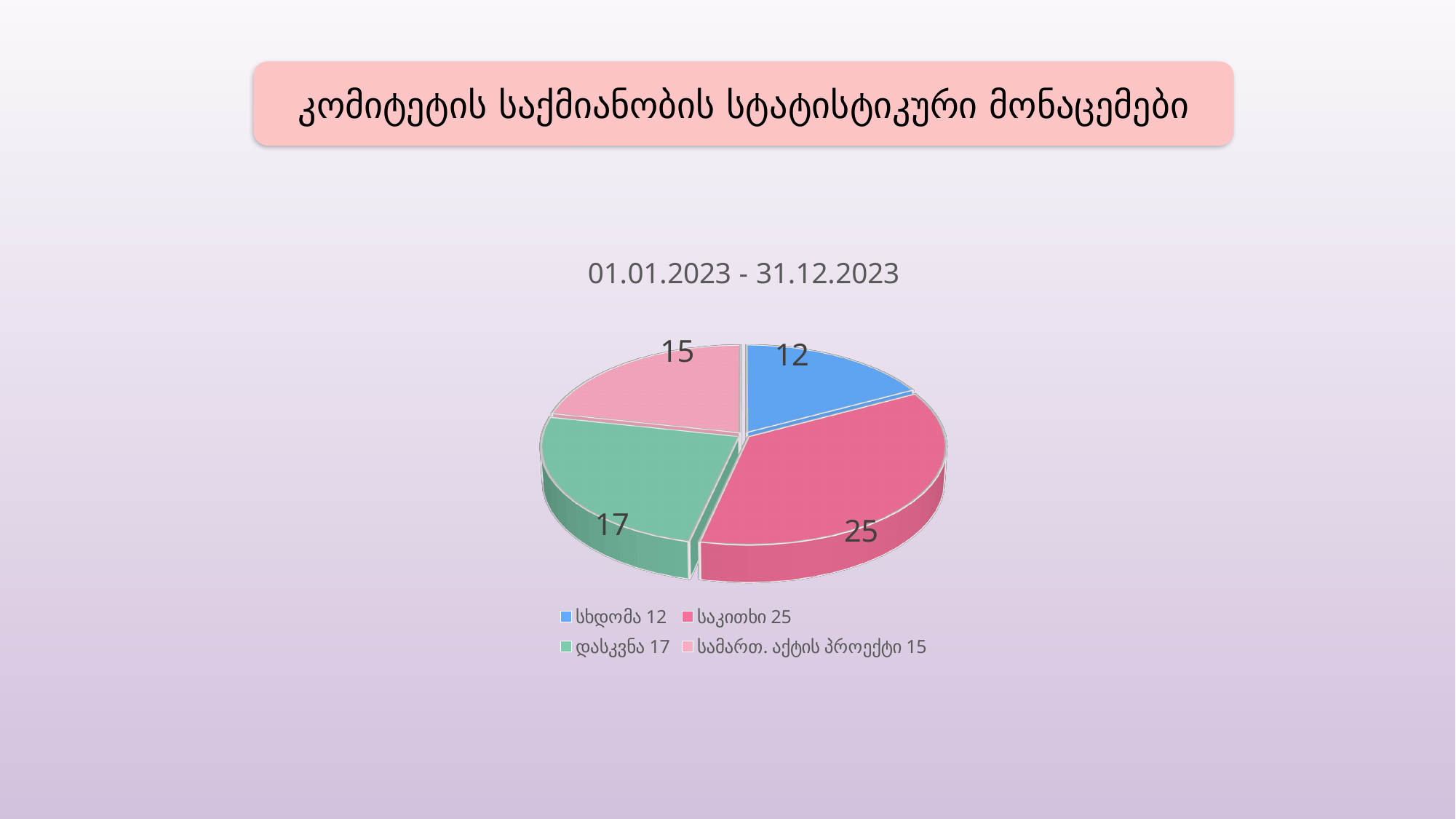
What colour is the slice for საკითხი? Red/pink What is the value for სხდომა? 12 Which category has the smallest slice? სხდომა Which is larger, დასკვნა or სამართ. აქტის პროექტი? დასკვნა What kind of chart is shown on the slide? Pie chart What is the value for საკითხი? 25 What is the value for დასკვნა? 17 What is the value for სამართ. აქტის პროექტი? 15 What is the difference between the values for საკითხი and სხდომა? 13 What is the title of the chart? 01.01.2023 - 31.12.2023 Which category has the largest slice? საკითხი How many slices does the pie chart have? 4